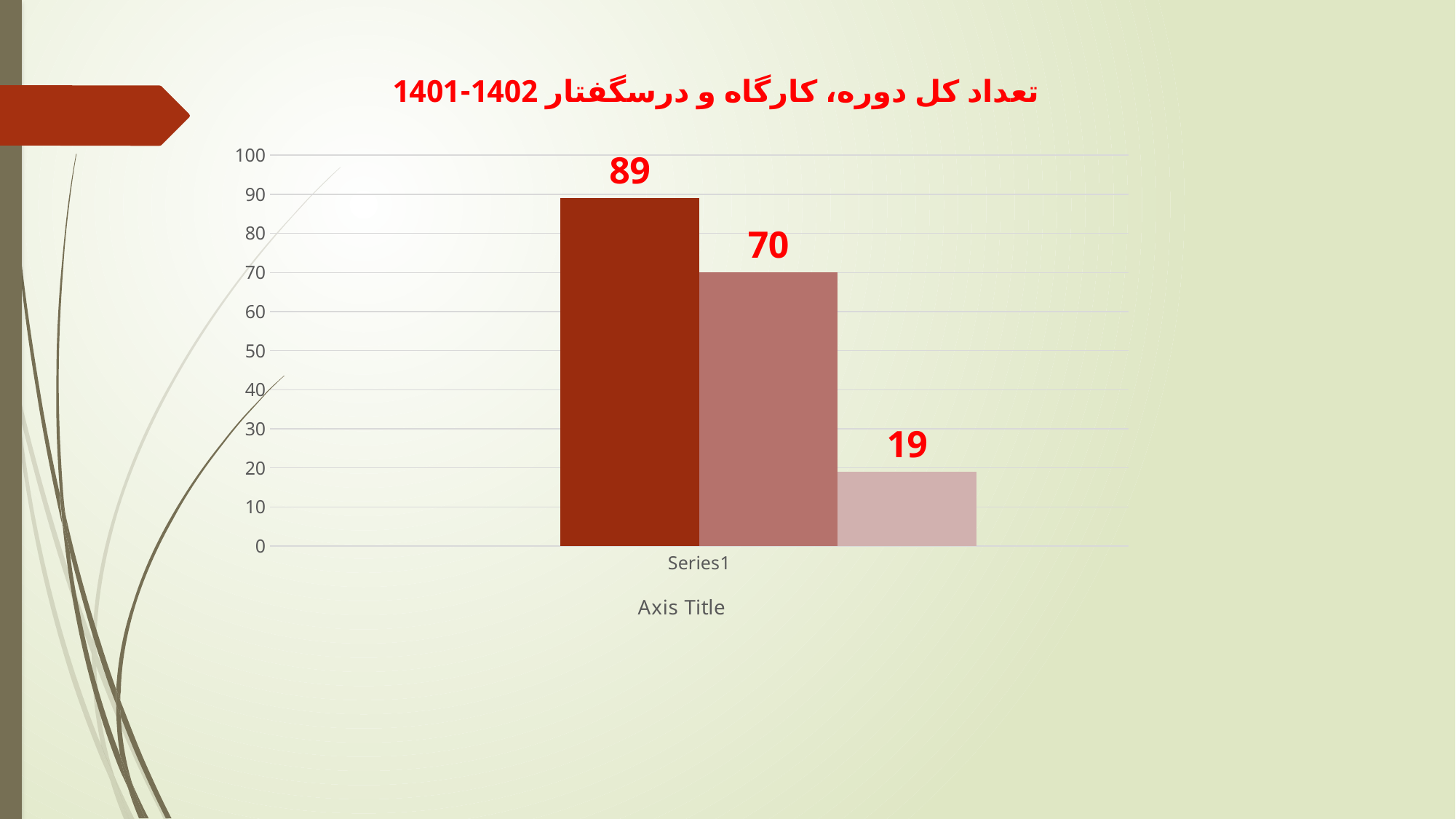
What is the value of the rightmost (light pink) bar? 19 Which is larger, the leftmost bar or the rightmost bar? the leftmost bar What is the value of the middle bar? 70 What is the highest value shown in the chart? 89 Do the bar values rise or fall from left to right? fall Is the value of the middle bar greater or less than 60? greater How many bars are plotted in the chart? 3 What is the lowest value shown in the chart? 19 What type of chart is shown on the slide? bar chart What is the difference between the middle bar and the rightmost bar? 51 What is the value of the leftmost (dark red) bar? 89 What is the difference between the leftmost bar and the middle bar? 19